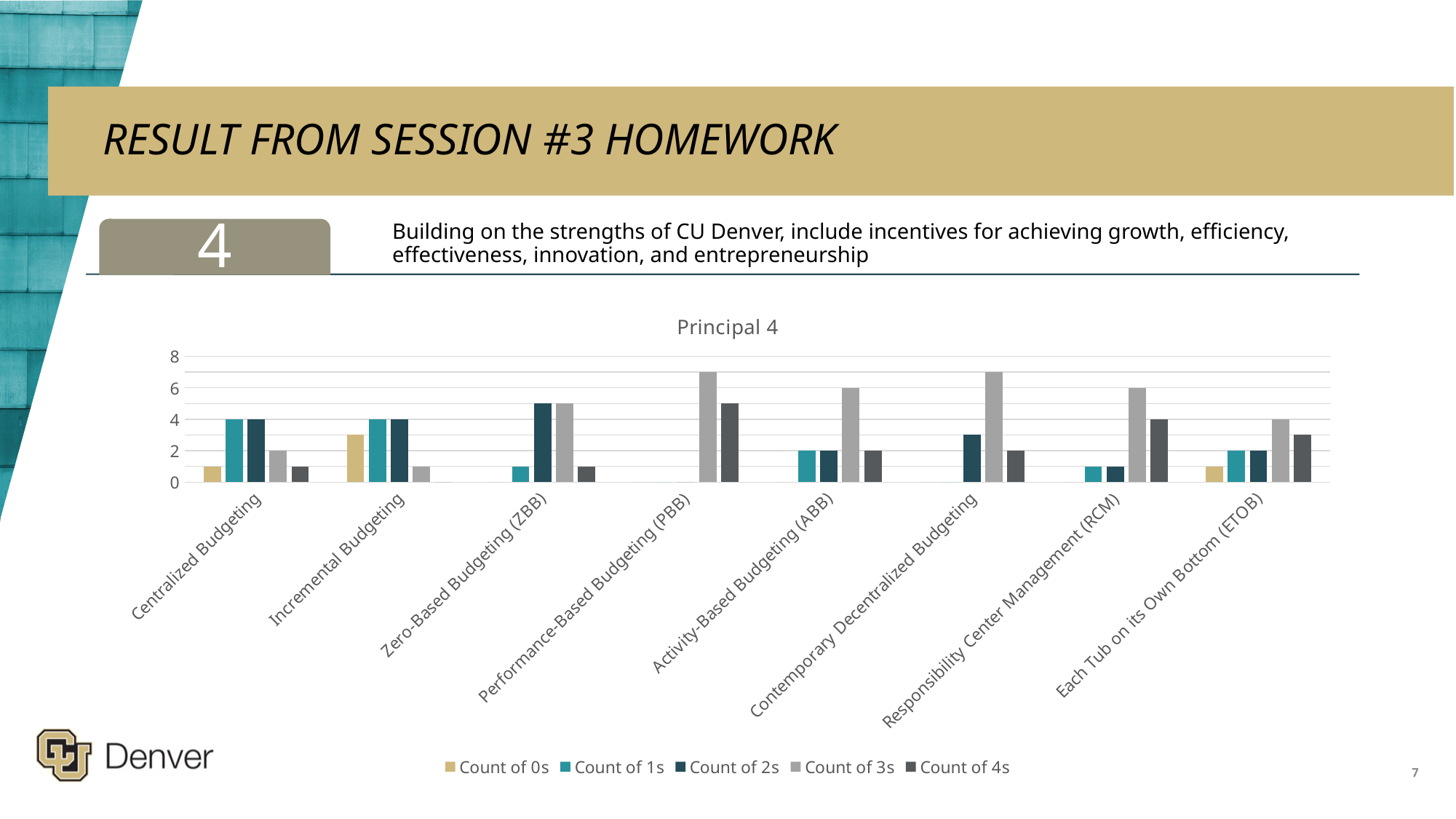
What is the title of the chart? Principal 4 Is the Count of 0s for Incremental Budgeting greater or less than 2? greater What kind of chart is shown on the slide? bar chart What is the Count of 1s for Centralized Budgeting? 4 How many budgeting categories are shown on the x axis of the Principal 4 chart? 8 For Responsibility Center Management (RCM), which is larger: Count of 3s or Count of 4s? Count of 3s How many series does the legend of the Principal 4 chart list? 5 What is the Count of 4s for Responsibility Center Management (RCM)? 4 For Activity-Based Budgeting (ABB), what is the difference between the Count of 3s and the Count of 4s? 4 Is the Count of 3s for Performance-Based Budgeting (PBB) greater or less than 6? greater What is the Count of 3s for Activity-Based Budgeting (ABB)? 6 Which category has the lowest Count of 3s? Incremental Budgeting